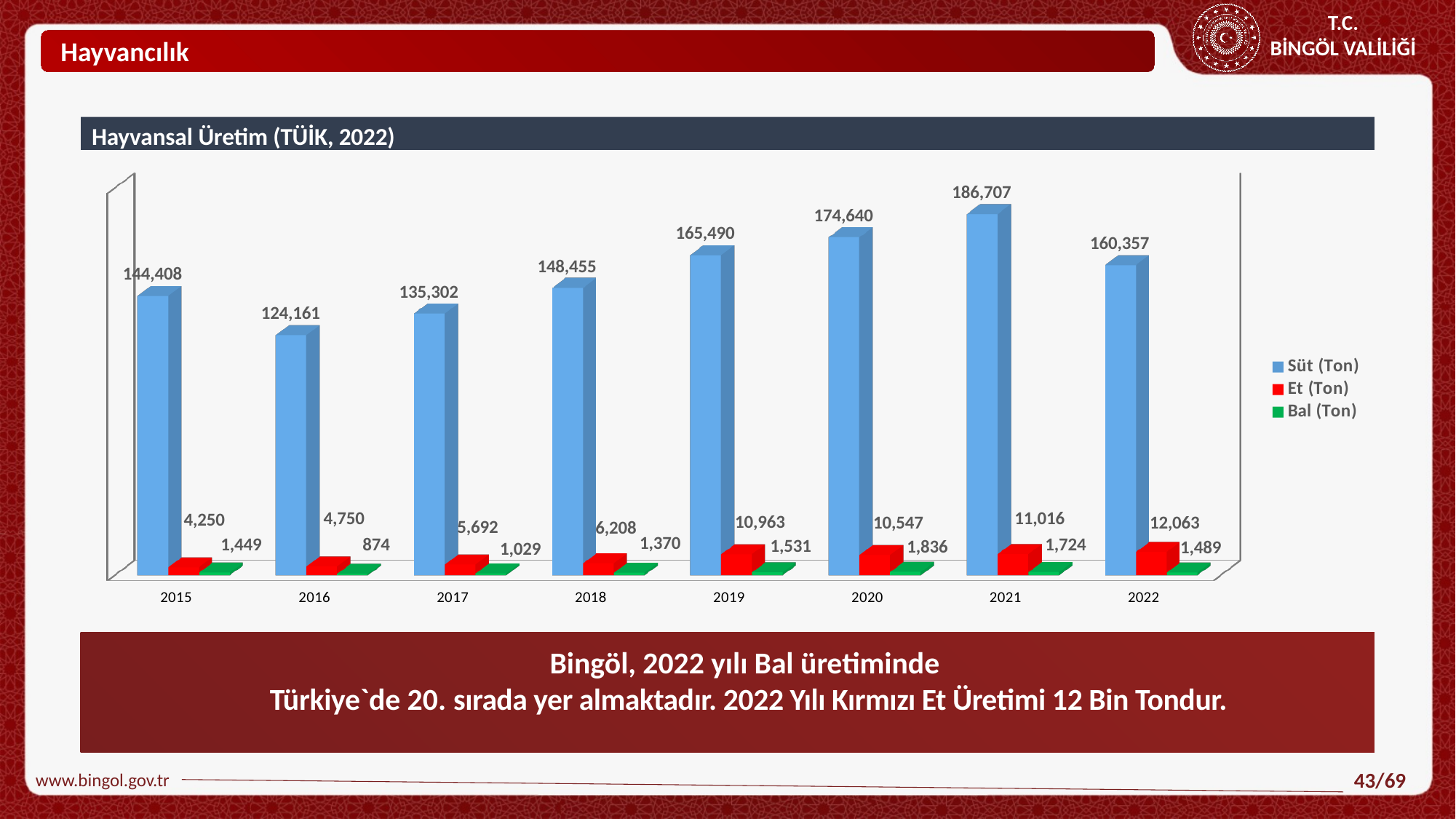
In which year is Süt (Ton) production highest? 2021 What is the difference between the Et (Ton) values for 2022 and 2021? 1,047 What is the Süt (Ton) value for 2021? 186,707 In which year is Bal (Ton) production lowest? 2016 In which year is Et (Ton) production highest? 2022 How many series does the legend list? 3 What is the difference between the Süt (Ton) values for 2021 and 2022? 26,350 What kind of chart is shown on the slide? Bar chart Which is larger, the Bal (Ton) value for 2020 or for 2022? 2020 How many years are shown on the x axis of the chart? 8 What is the Et (Ton) value for 2019? 10,963 What is the Bal (Ton) value for 2016? 874